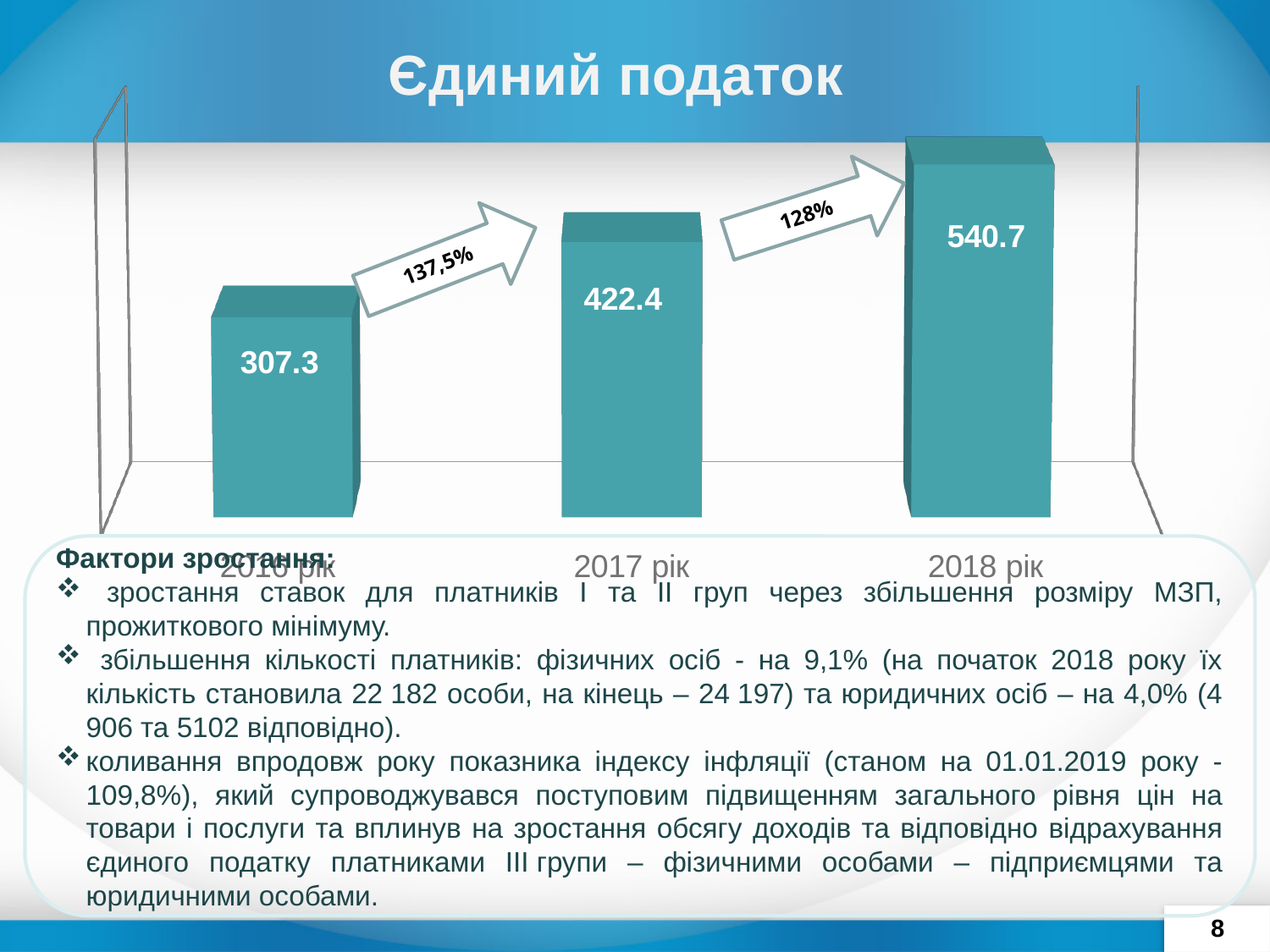
Do the values rise or fall from 2016 рік to 2018 рік? rise Which year has the highest value? 2018 рік What is the value shown for 2016 рік? 307.3 What is the difference between the values for 2018 рік and 2017 рік? 118.3 Which is larger, the value for 2017 рік or the value for 2016 рік? 2017 рік What is the value shown for 2018 рік? 540.7 How many years (categories) are shown in the chart? 3 What is the title of the chart? Єдиний податок What is the difference between the values for 2017 рік and 2016 рік? 115.1 What kind of chart is shown on the slide? bar chart Which year has the lowest value? 2016 рік What is the value shown for 2017 рік? 422.4